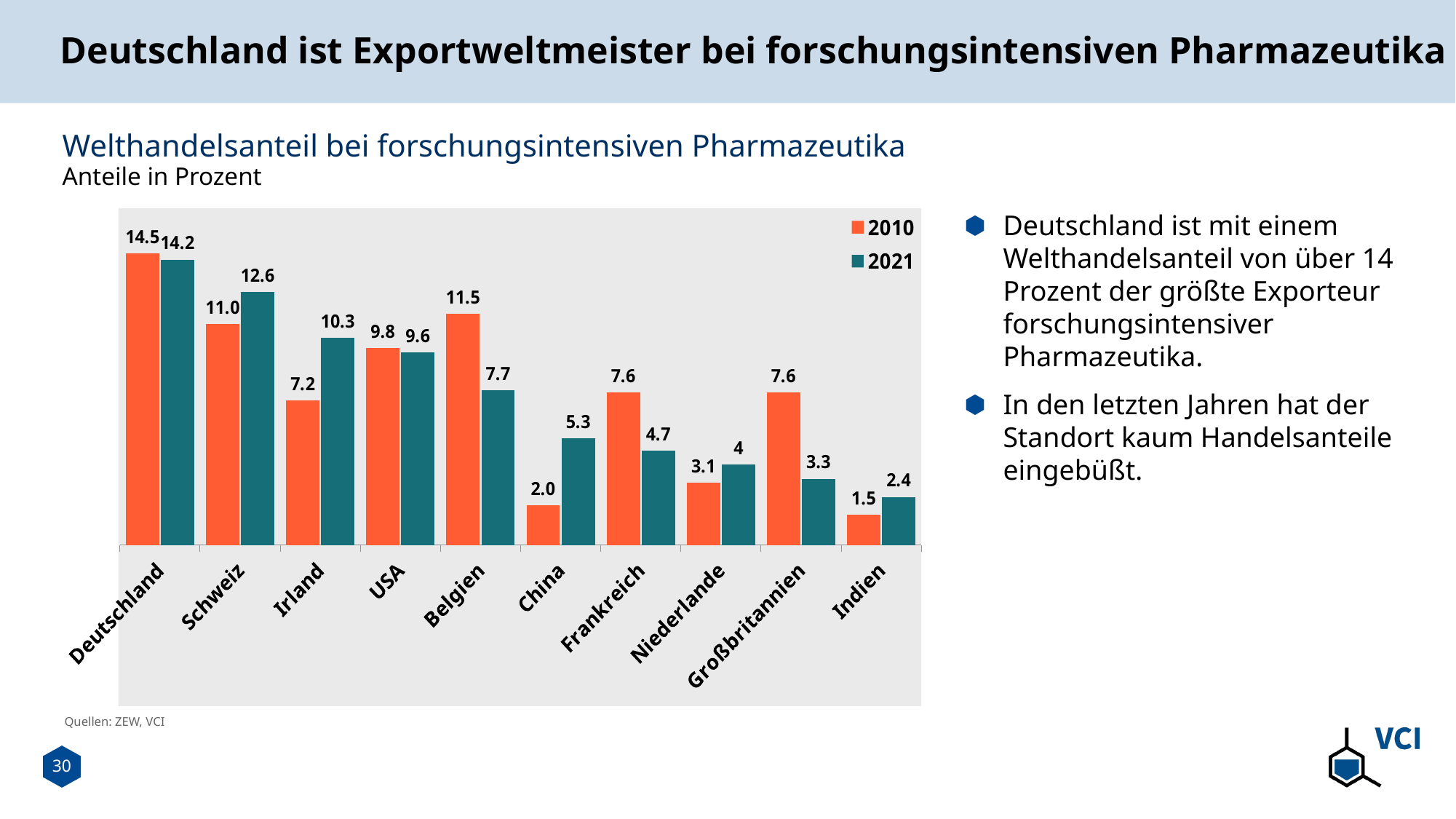
Which country has the lowest value in 2010? Indien What is the difference between the 2010 and 2021 values for Belgien? 3.8 What kind of chart is shown on the slide? bar chart What is the title of the chart? Welthandelsanteil bei forschungsintensiven Pharmazeutika Which is larger for Schweiz: the 2010 value or the 2021 value? 2021 What is the value for Deutschland in 2010? 14.5 How many countries are shown on the x axis? 10 What is the value for China in 2010? 2.0 Which country has the highest value in 2021? Deutschland What is the difference between the 2010 and 2021 values for Großbritannien? 4.3 How many series does the legend list? 2 What is the value for Irland in 2021? 10.3